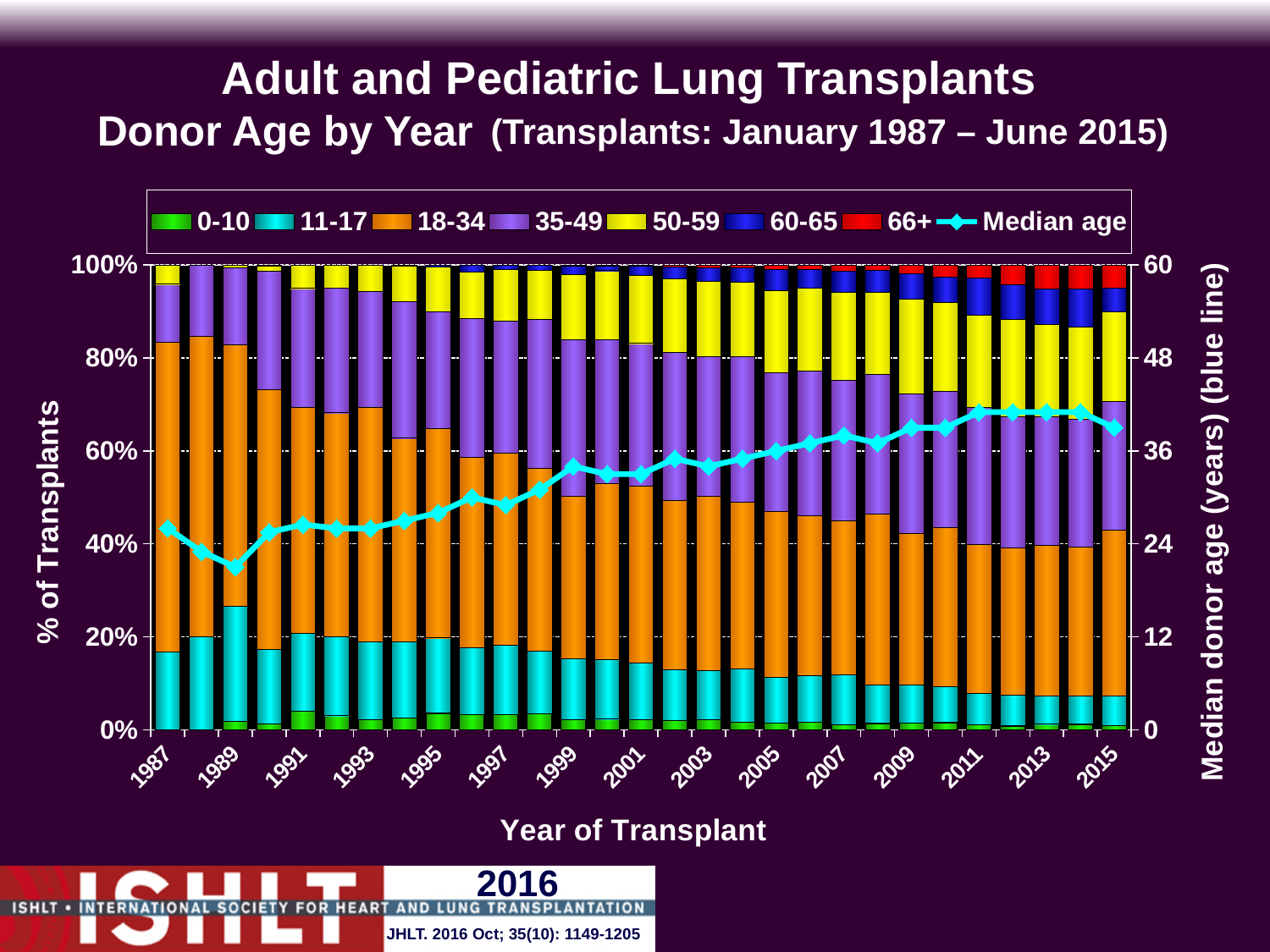
Is the median donor age for 2013 greater or less than 36 years? greater Is the median donor age for 2003 greater or less than 24 years? greater Which year has the lowest median donor age? 1989 What kind of chart is shown on the slide? Stacked bar chart with a line What is the label of the x axis? Year of Transplant Does the median donor age line generally rise or fall from 1989 to 2015? Rise Which legend entry is shown in red? 66+ Is the median donor age for 1989 greater or less than 24 years? less Which year has the higher median donor age, 1989 or 2013? 2013 How many years (bars) are plotted along the x axis? 29 How many entries does the legend list? 8